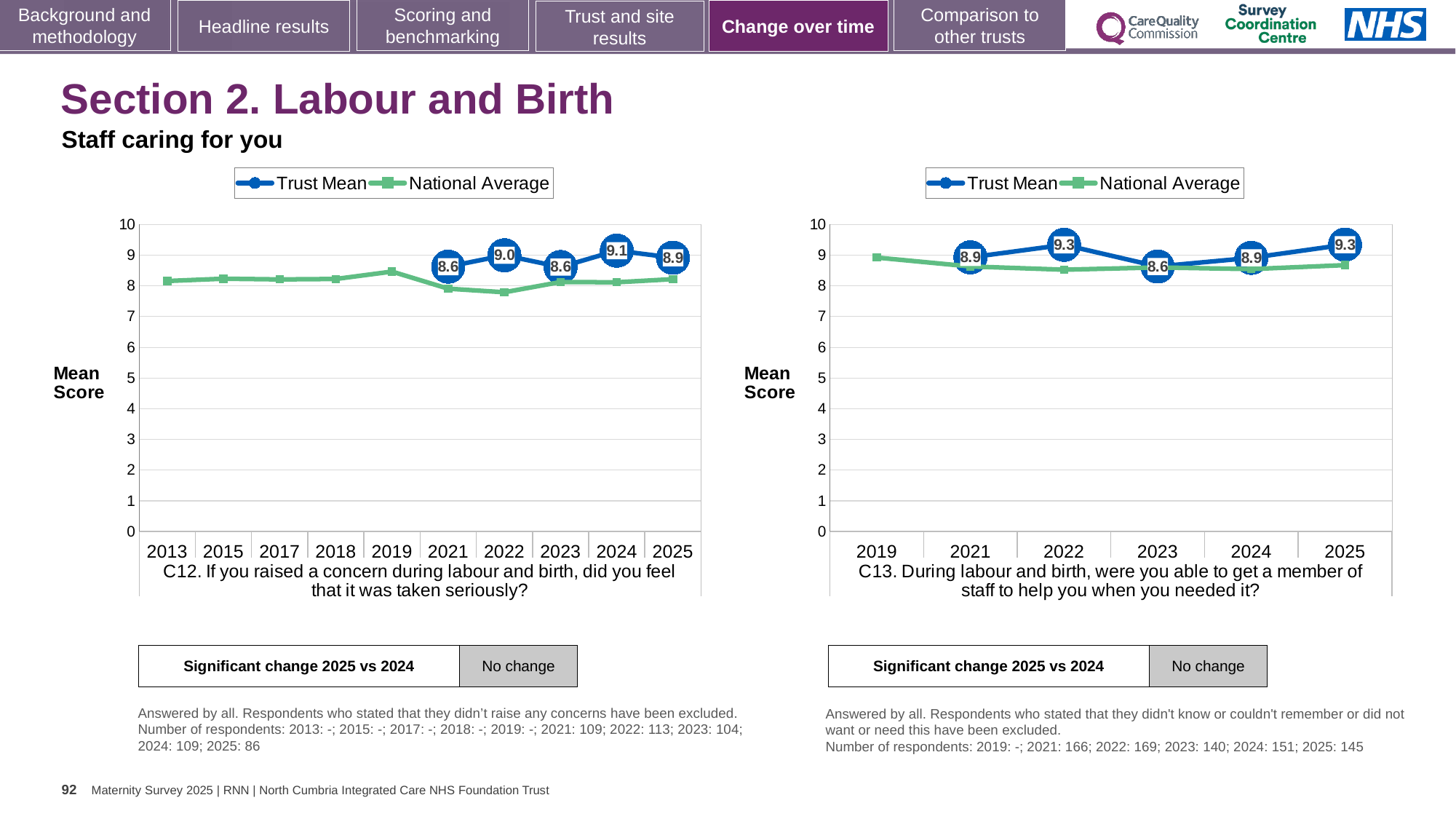
In the C13 chart on the right, what is the difference between the Trust Mean values for 2022 and 2023? 0.7 In the C12 chart on the left, what is the difference between the Trust Mean values for 2024 and 2025? 0.2 In the C12 chart on the left, is the National Average value for 2013 greater or less than 9? less In the C12 chart on the left, which year has the highest Trust Mean value? 2024 How many series does the legend of the C13 chart on the right list? 2 How many years are shown on the x axis of the C12 chart on the left? 10 What is the result shown in the 'Significant change 2025 vs 2024' box below the C12 chart on the left? No change In the C12 chart on the left, is the Trust Mean value larger in 2022 or 2023? 2022 In the C13 chart on the right, what is the Trust Mean value for 2023? 8.6 In the C12 chart on the left, what is the Trust Mean value for 2024? 9.1 What kind of chart is the C13 chart on the right? Line chart In the C13 chart on the right, which year has the lowest Trust Mean value? 2023